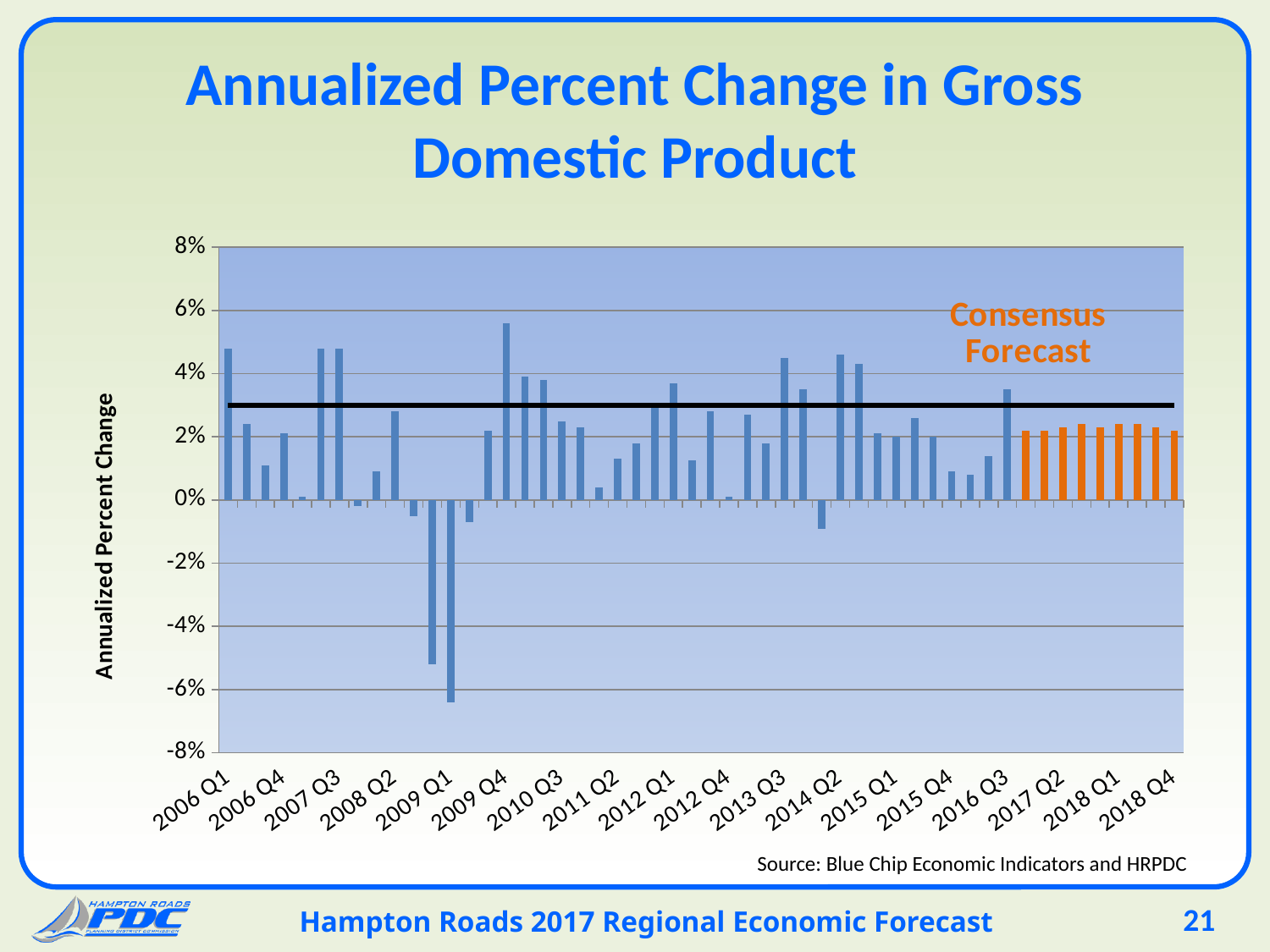
What do the orange bars at the right of the chart represent? Consensus Forecast Is the value for 2006 Q1 greater or less than 4%? greater Is the value for 2009 Q4 greater or less than 4%? greater Which quarter has the highest annualized percent change in GDP? 2009 Q4 Which is larger, the value for 2009 Q1 or the value for 2009 Q4? 2009 Q4 Is the value for 2009 Q1 greater or less than -2%? less What label is shown on the vertical axis? Annualized Percent Change What kind of chart is shown on the slide? bar chart Which quarter has the lowest annualized percent change in GDP? 2009 Q1 Which is larger, the value for 2006 Q1 or the value for 2006 Q4? 2006 Q1